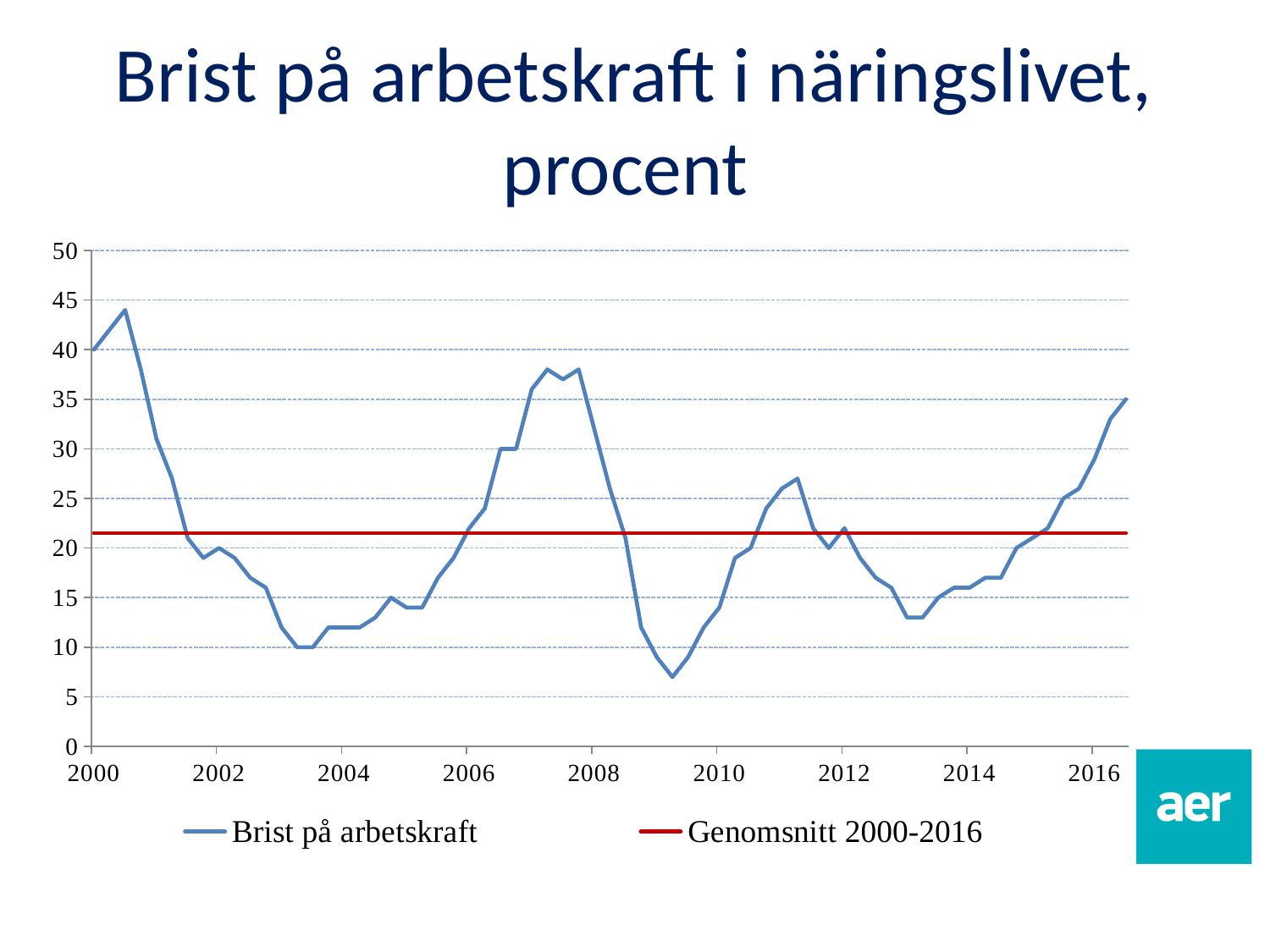
In which year does Brist på arbetskraft reach its lowest point? 2009 What colour is the line for Genomsnitt 2000-2016? red Is the value for Brist på arbetskraft at 2000 greater or less than 35? greater What kind of chart is shown on the slide? line chart Is the value for Brist på arbetskraft at 2010 greater or less than 20? less Is the value for Brist på arbetskraft at 2004 greater or less than 15? less Which is larger, the value for Brist på arbetskraft at 2004 or at 2008? 2008 What is the title of the chart? Brist på arbetskraft i näringslivet, procent Does Brist på arbetskraft rise or fall between 2014 and 2016? rise How many series does the legend list? 2